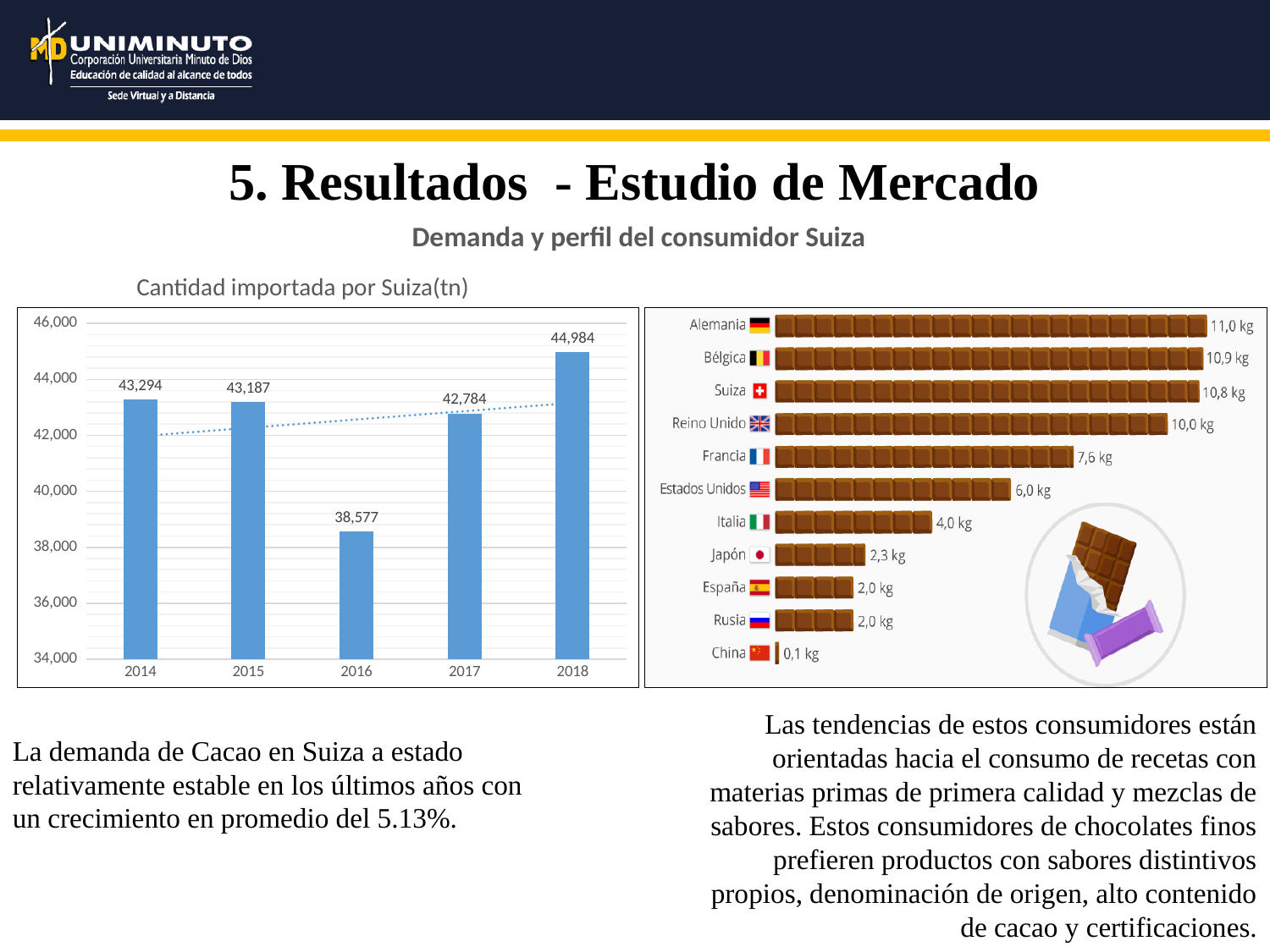
In the chart 'Cantidad importada por Suiza(tn)', is the value for 2016 greater or less than 40,000? less In the chart 'Cantidad importada por Suiza(tn)', what is the difference between the values for 2018 and 2017? 2,200 In the chart 'Cantidad importada por Suiza(tn)', what is the value for 2016? 38,577 What kind of chart is 'Cantidad importada por Suiza(tn)'? bar chart In the chart 'Cantidad importada por Suiza(tn)', which year has the highest value? 2018 In the chart on the right of the slide, which is larger, the value for Francia or the value for Estados Unidos? Francia In the chart 'Cantidad importada por Suiza(tn)', how many years are shown on the x axis? 5 In the chart 'Cantidad importada por Suiza(tn)', which year has the lowest value? 2016 In the chart on the right of the slide, which country has the highest value? Alemania In the chart on the right of the slide, which country has the lowest value? China In the chart on the right of the slide, what is the value for Suiza? 10,8 kg In the chart 'Cantidad importada por Suiza(tn)', what is the value for 2018? 44,984